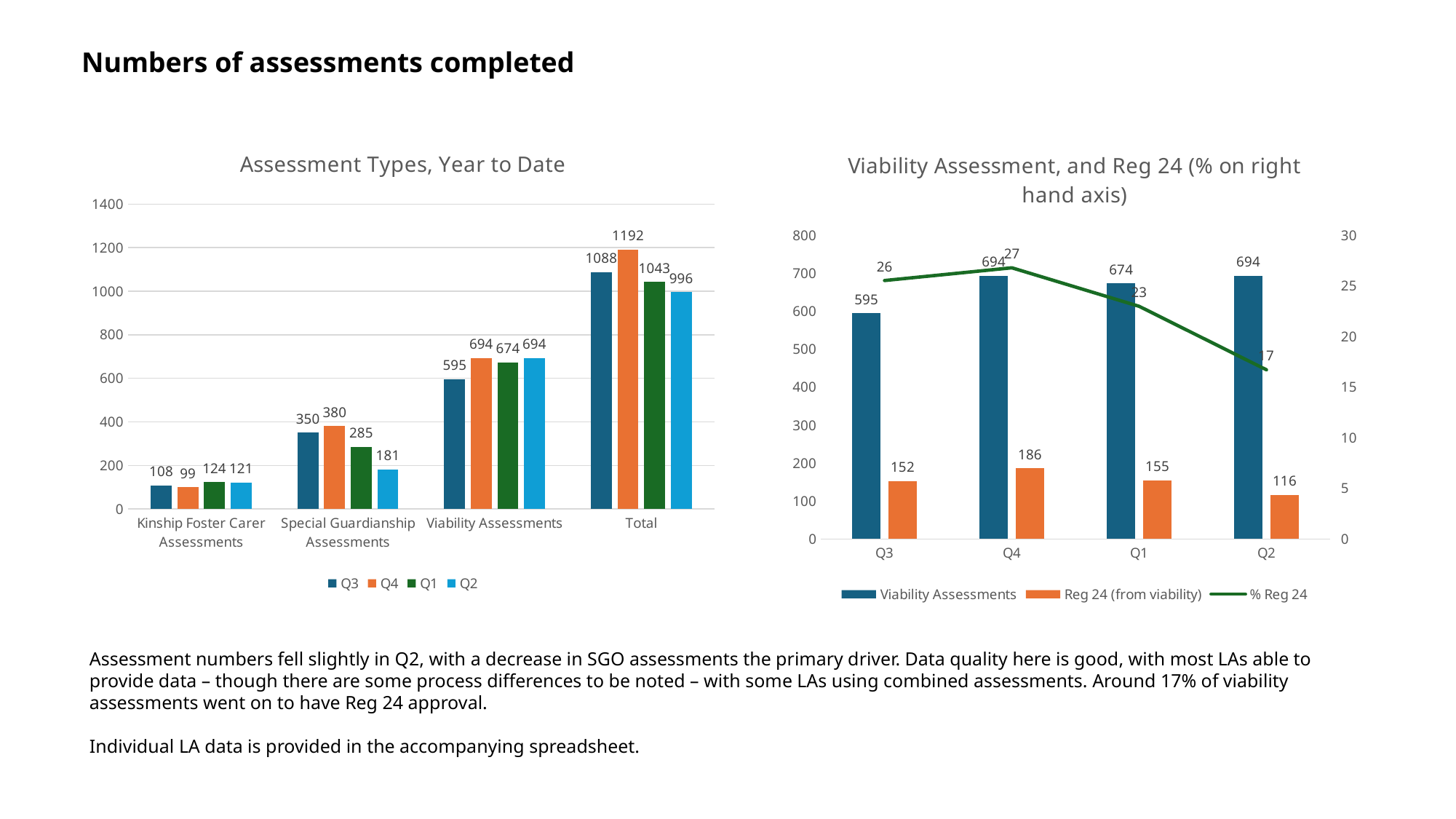
In the 'Assessment Types, Year to Date' chart, which quarter has the lowest value for Kinship Foster Carer Assessments? Q4 In the 'Assessment Types, Year to Date' chart, what is the difference between the Q4 and Q2 values for Special Guardianship Assessments? 199 In the 'Viability Assessment, and Reg 24' chart, which quarter has the lowest Reg 24 (from viability) value? Q2 In the 'Viability Assessment, and Reg 24' chart, does the % Reg 24 line rise or fall from Q4 to Q2? fall In the 'Assessment Types, Year to Date' chart, how many series does the legend list? 4 In the 'Viability Assessment, and Reg 24' chart, what is the % Reg 24 value for Q2? 17 In the 'Assessment Types, Year to Date' chart, what is the Q4 value for Special Guardianship Assessments? 380 In the 'Viability Assessment, and Reg 24' chart, what is the Reg 24 (from viability) value for Q4? 186 In the 'Viability Assessment, and Reg 24' chart, is the Viability Assessments value for Q3 larger or smaller than the value for Q1? smaller In the 'Assessment Types, Year to Date' chart, which quarter has the highest Total? Q4 In the 'Assessment Types, Year to Date' chart, how many categories are shown on the x axis? 4 In the 'Assessment Types, Year to Date' chart, what is the Q2 value for Total? 996